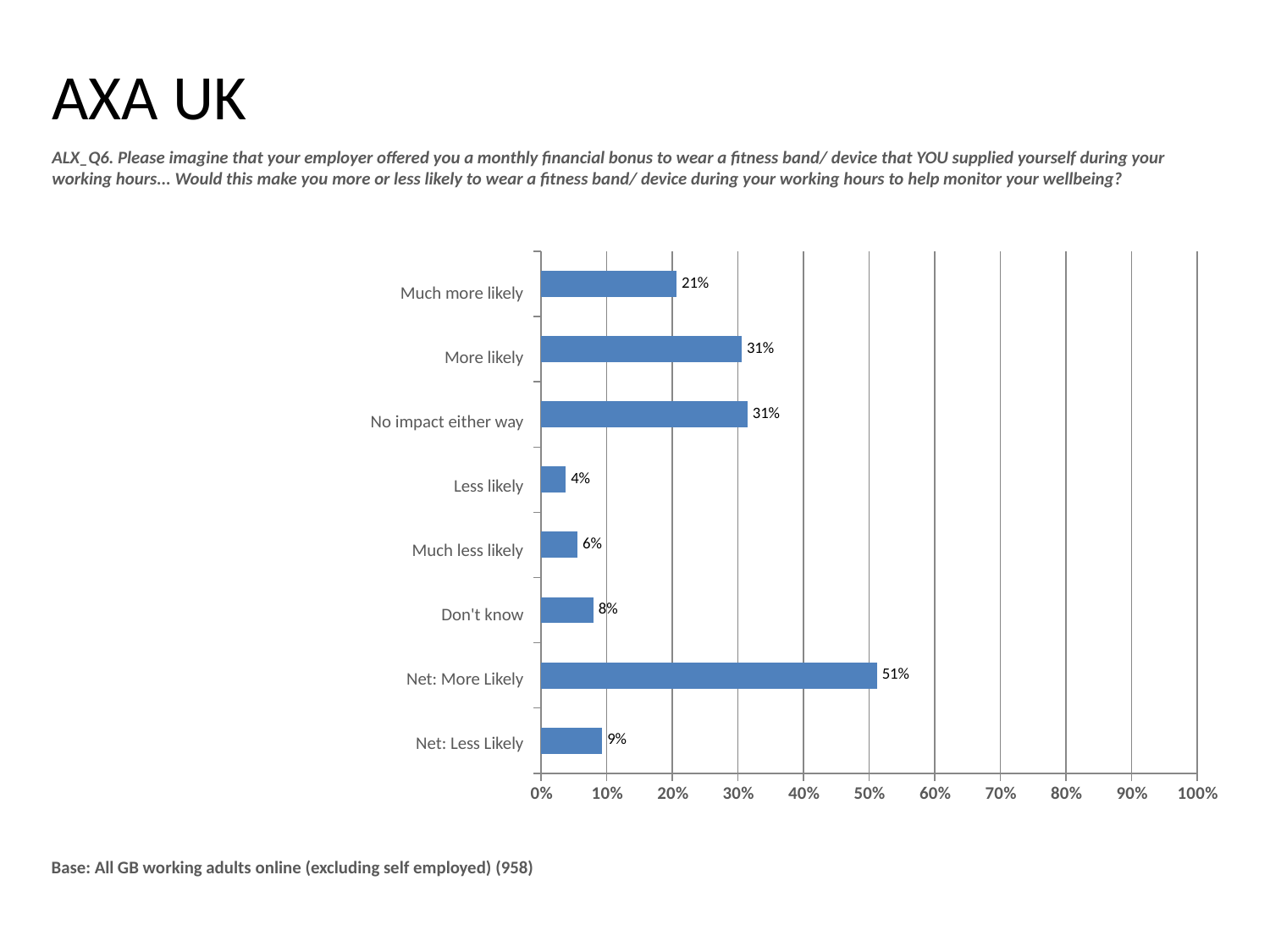
How many categories are shown in the chart? 8 What is the value for "Much less likely"? 6% What is the value for "Don't know"? 8% Which category has the highest value? Net: More Likely What is the value for "Much more likely"? 21% What kind of chart is shown on the slide? Bar chart What is the difference between "Net: More Likely" and "Net: Less Likely"? 42% What is the base size stated below the chart? 958 What is the value for "Net: More Likely"? 51% Is the value for "No impact either way" greater or less than 30%? greater Which is larger, "More likely" or "Much more likely"? More likely Which category has the lowest value? Less likely